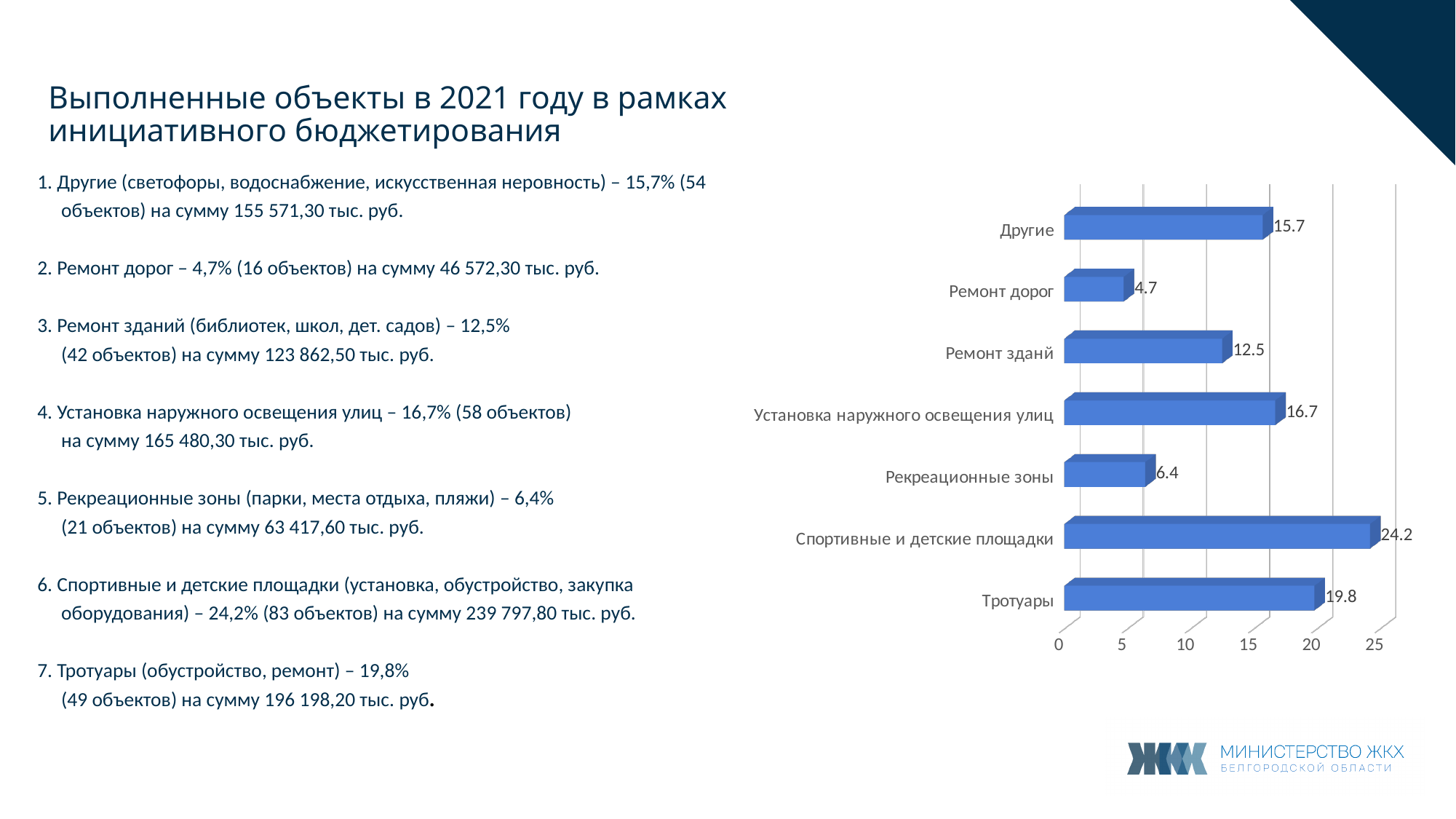
What is the value shown for Спортивные и детские площадки? 24.2 What is the difference between the values for Тротуары and Другие? 4.1 What is the highest value labelled on the horizontal axis of the chart? 25 Which is larger, the value for Ремонт зданй or the value for Рекреационные зоны? Ремонт зданй Which category has the lowest value? Ремонт дорог What is the difference between the values for Спортивные и детские площадки and Ремонт дорог? 19.5 Which category has the highest value? Спортивные и детские площадки Is the value for Тротуары greater or less than 15? greater What is the value shown for Ремонт дорог? 4.7 How many categories are shown in the chart? 7 What is the value shown for Установка наружного освещения улиц? 16.7 What kind of chart is shown on the slide? bar chart